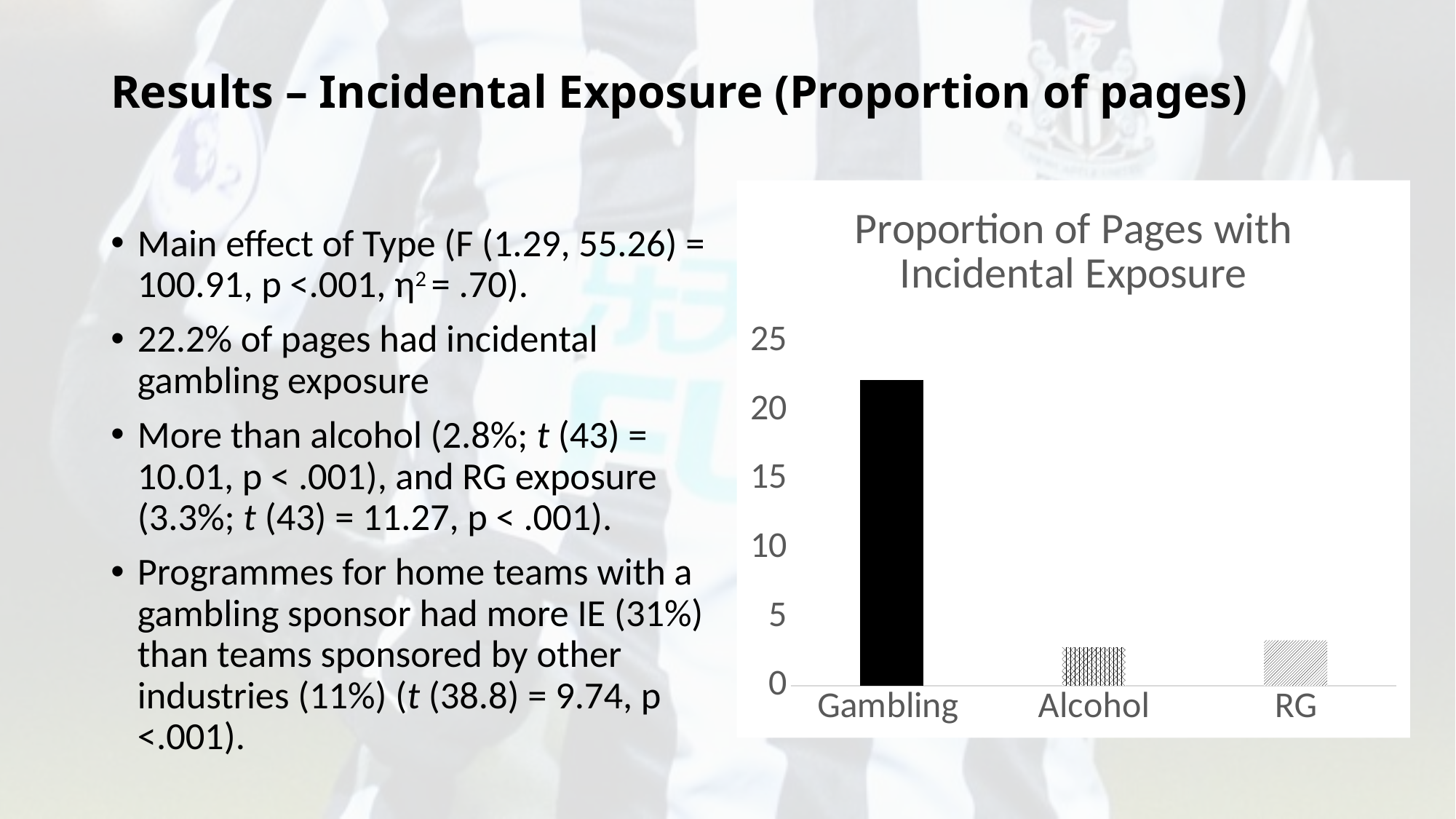
Which is larger, the value for Gambling or the value for Alcohol? Gambling What kind of chart is shown on the slide? bar chart Is the value for RG greater or less than 5? less Is the value for Alcohol greater or less than 5? less What is the highest tick value shown on the y axis of the chart? 25 Which is larger, the value for Gambling or the value for RG? Gambling What is the title of the chart? Proportion of Pages with Incidental Exposure Is the value for Gambling greater or less than 25? less Which category is plotted first (leftmost) on the x axis? Gambling Which category has the highest bar in the chart? Gambling How many categories are shown on the x axis of the chart? 3